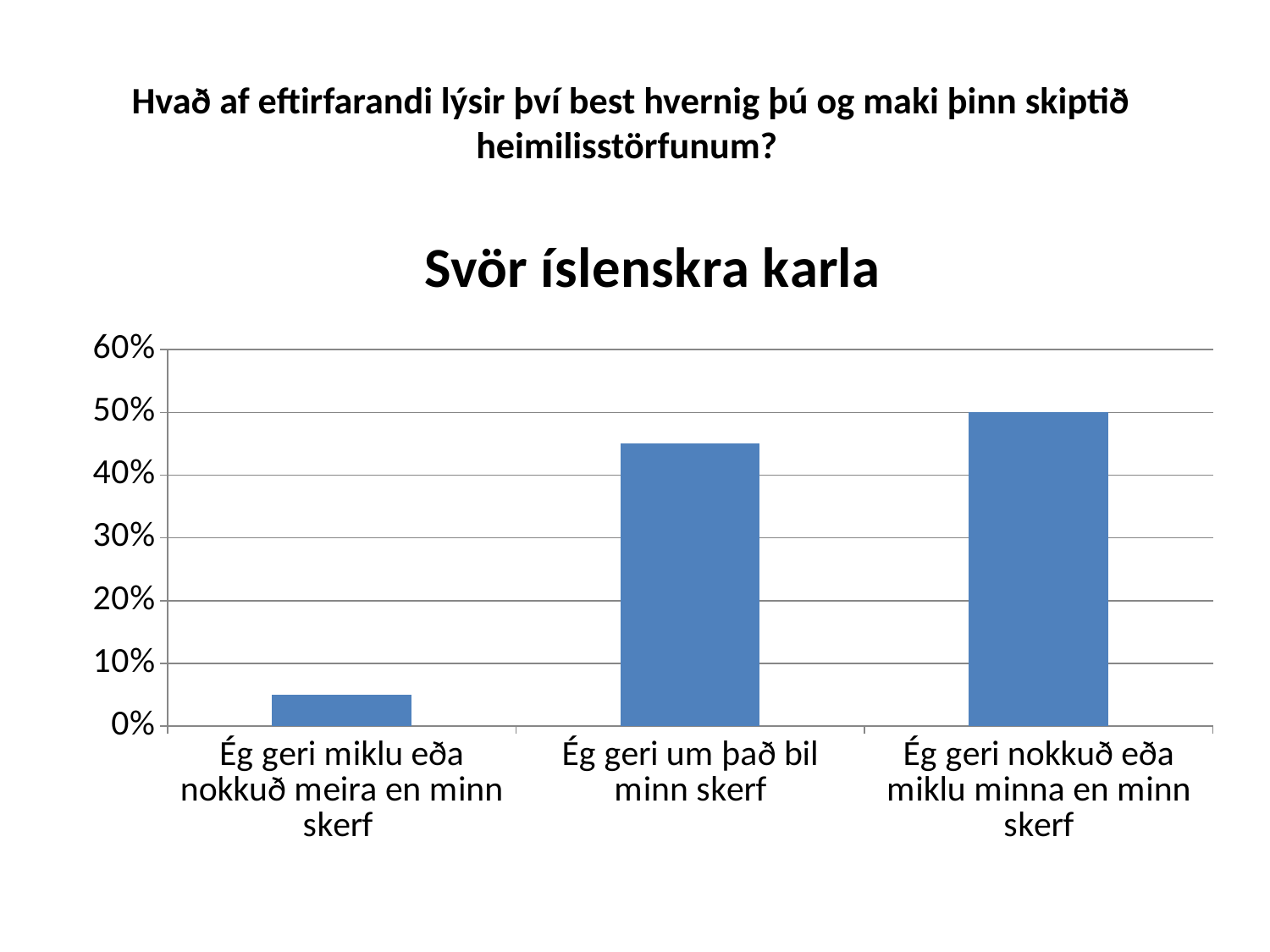
What is the value for "Ég geri nokkuð eða miklu minna en minn skerf"? 50% What kind of chart is shown on the slide? bar chart Which category has the highest value? Ég geri nokkuð eða miklu minna en minn skerf Which category has the lowest value? Ég geri miklu eða nokkuð meira en minn skerf Which is larger, the value for "Ég geri um það bil minn skerf" or the value for "Ég geri miklu eða nokkuð meira en minn skerf"? Ég geri um það bil minn skerf How many categories are shown on the x axis of the chart? 3 Do the values rise or fall from left to right along the x axis? rise Is the value for "Ég geri um það bil minn skerf" greater or less than 40%? greater What is the title of the chart? Svör íslenskra karla Is the value for "Ég geri miklu eða nokkuð meira en minn skerf" greater or less than 10%? less Is the value for "Ég geri um það bil minn skerf" greater or less than 50%? less What colour are the bars in the chart? blue